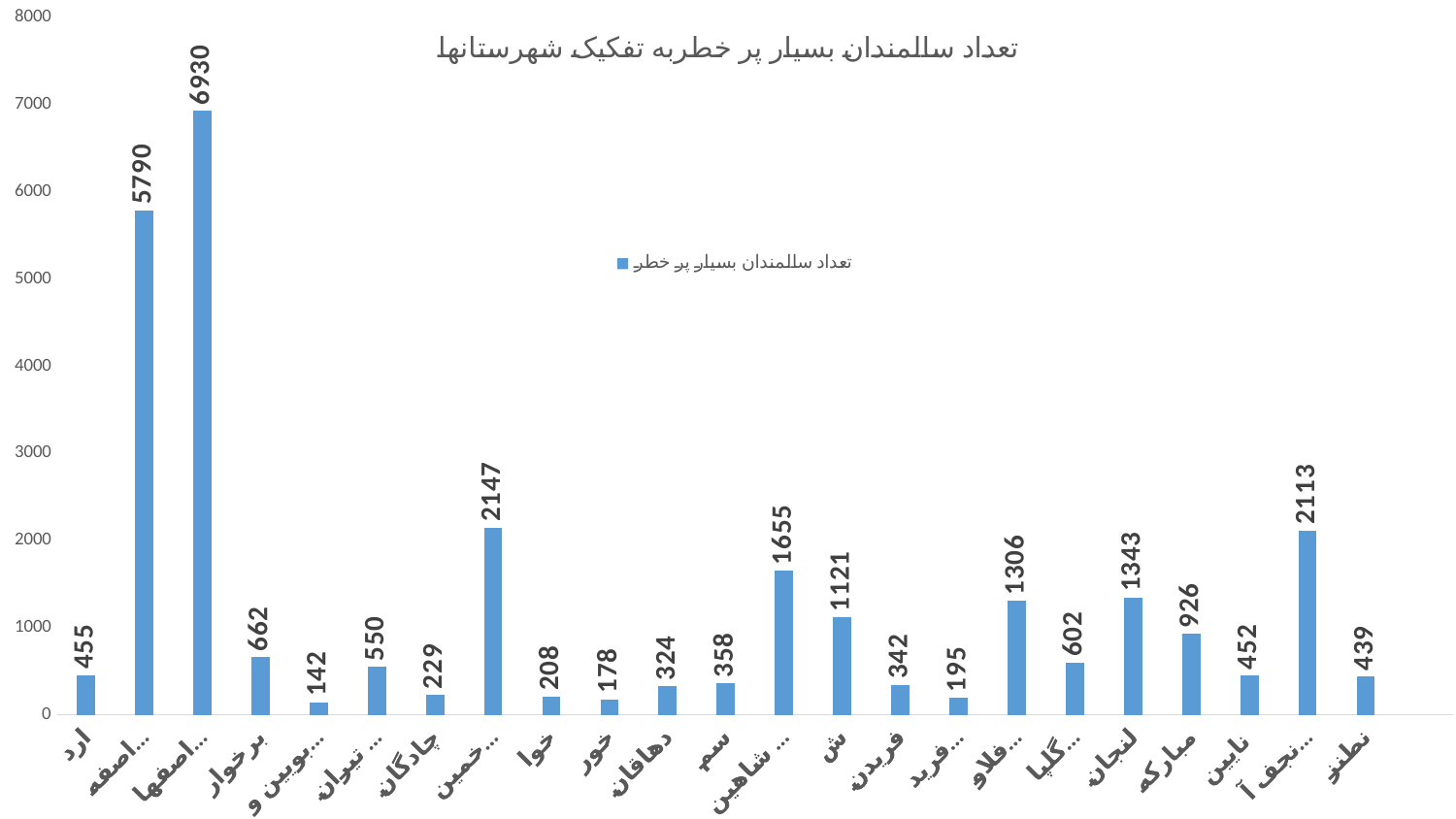
How many bars (categories) are shown in the chart? 23 What is the lowest value shown in the chart? 142 What is the value for نطنز? 439 What is the value for لنجان? 1343 What is the difference between the values for لنجان and مبارکه? 417 What is the value for چادگان? 229 Which has a larger value, برخوار or دهاقان? برخوار What is the difference between the values for فریدن and خور? 164 What is the value for مبارکه? 926 What is the highest value shown in the chart? 6930 How many series does the legend list? 1 What type of chart is shown on the slide? bar chart